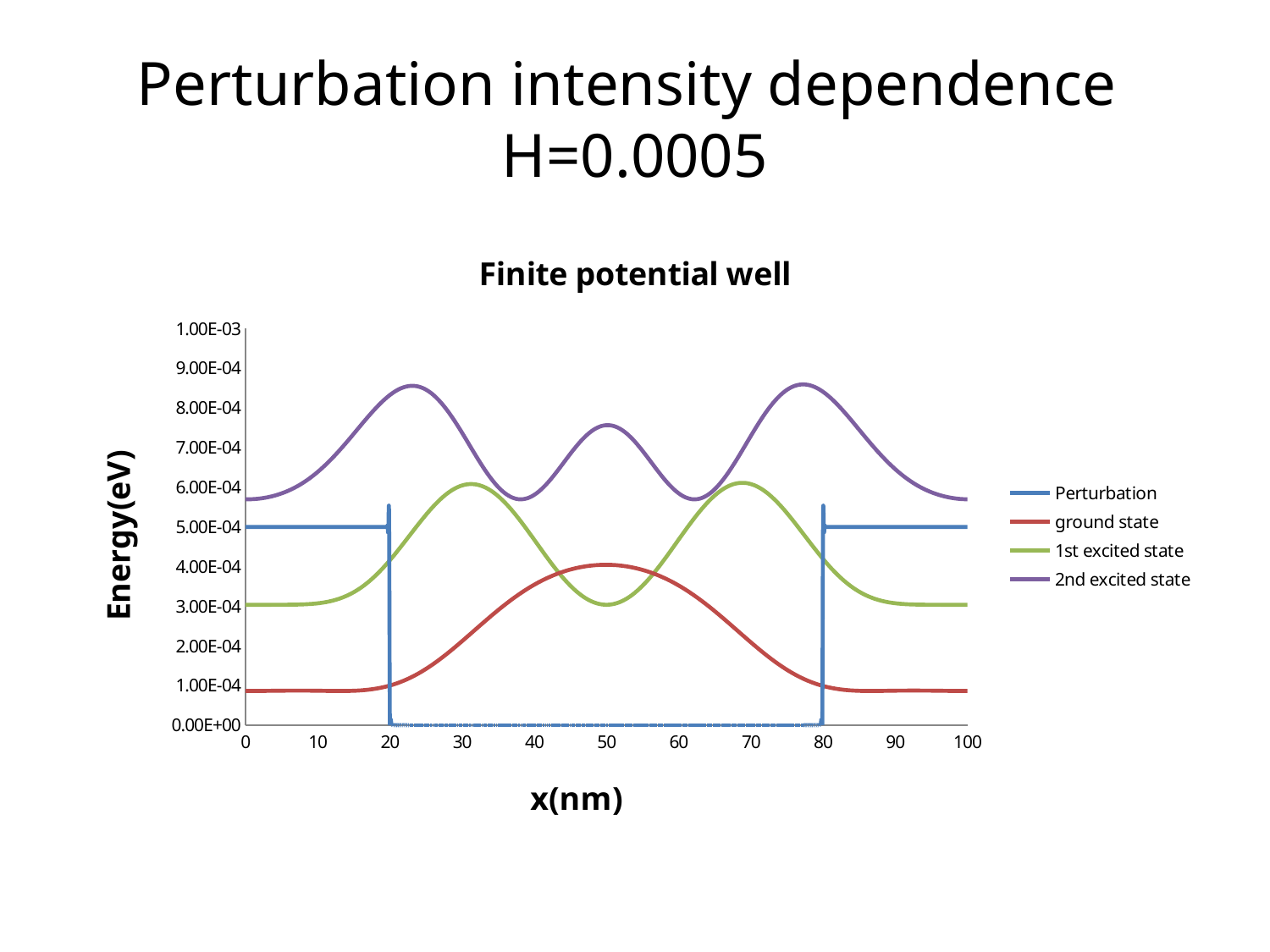
How many series does the legend of the "Finite potential well" chart list? 4 Which series reaches the highest value anywhere on the chart? 2nd excited state What is the value of the Perturbation series at x = 0? 5.00E-04 Which series has the lowest value at x = 0? ground state What is the title of the chart on the slide? Finite potential well What kind of chart is shown on the slide? line chart What is the label of the y axis of the chart? Energy(eV) Is the value of the ground state series at x = 50 greater or less than 5.00E-04? less Is the peak value of the 2nd excited state series greater or less than 8.00E-04? greater What is the value of the Perturbation series at x = 50? 0.00E+00 At x = 50, which series has the larger value: ground state or 2nd excited state? 2nd excited state Does the ground state series rise or fall as x goes from 20 to 50? rise